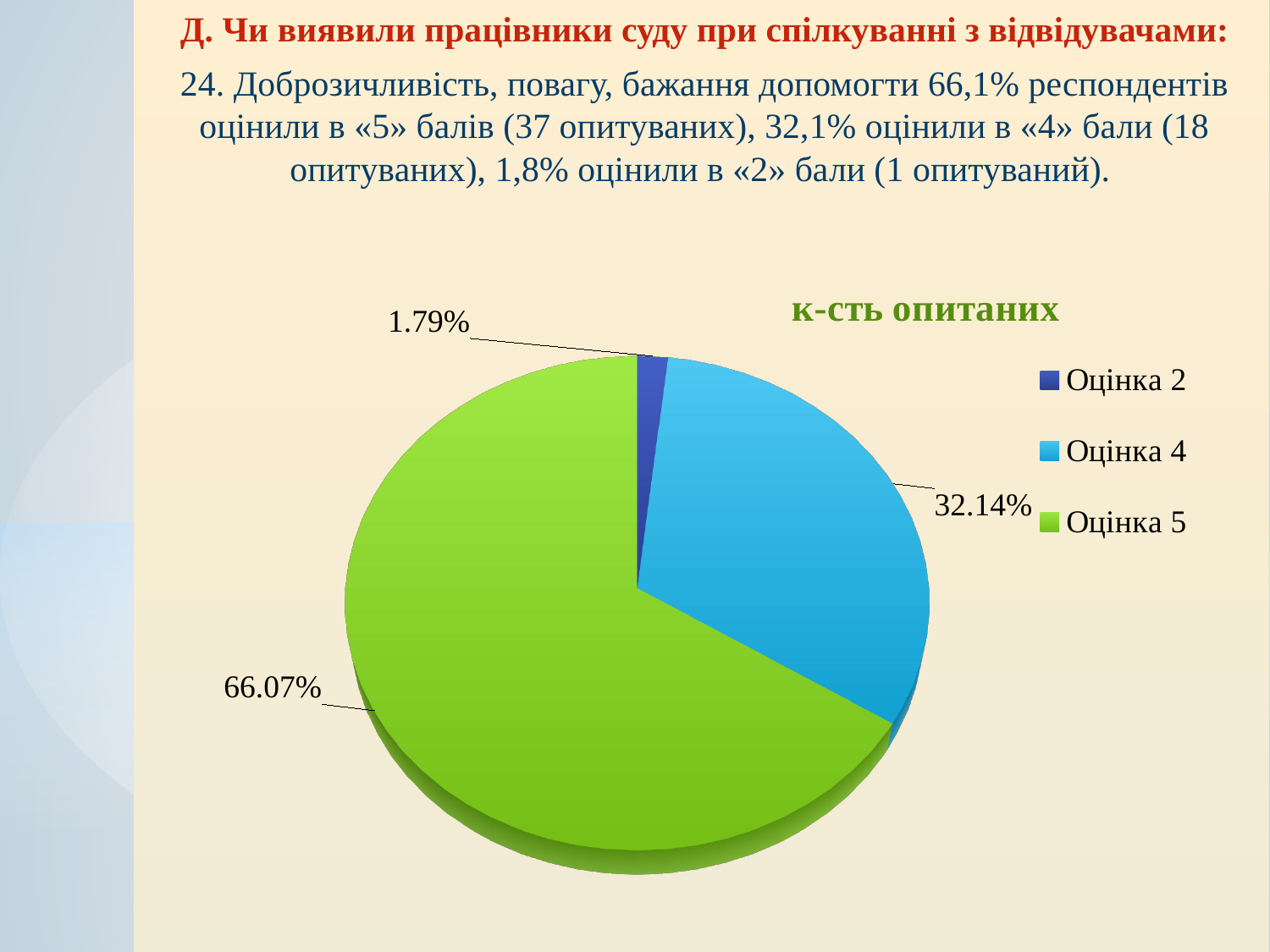
What type of chart is shown on the slide? pie chart What share of the pie does Оцінка 2 have? 1.79% What share of the pie does Оцінка 4 have? 32.14% What is the difference in percentage points between the Оцінка 5 slice and the Оцінка 4 slice? 33.93% Which category has the largest slice of the pie? Оцінка 5 Which is larger, the slice for Оцінка 4 or the slice for Оцінка 2? Оцінка 4 How many entries does the legend list? 3 How many slices does the pie chart have? 3 Which category has the smallest slice of the pie? Оцінка 2 What colour is the slice for Оцінка 4? light blue What is the title of the chart? к-сть опитаних What share of the pie does Оцінка 5 have? 66.07%